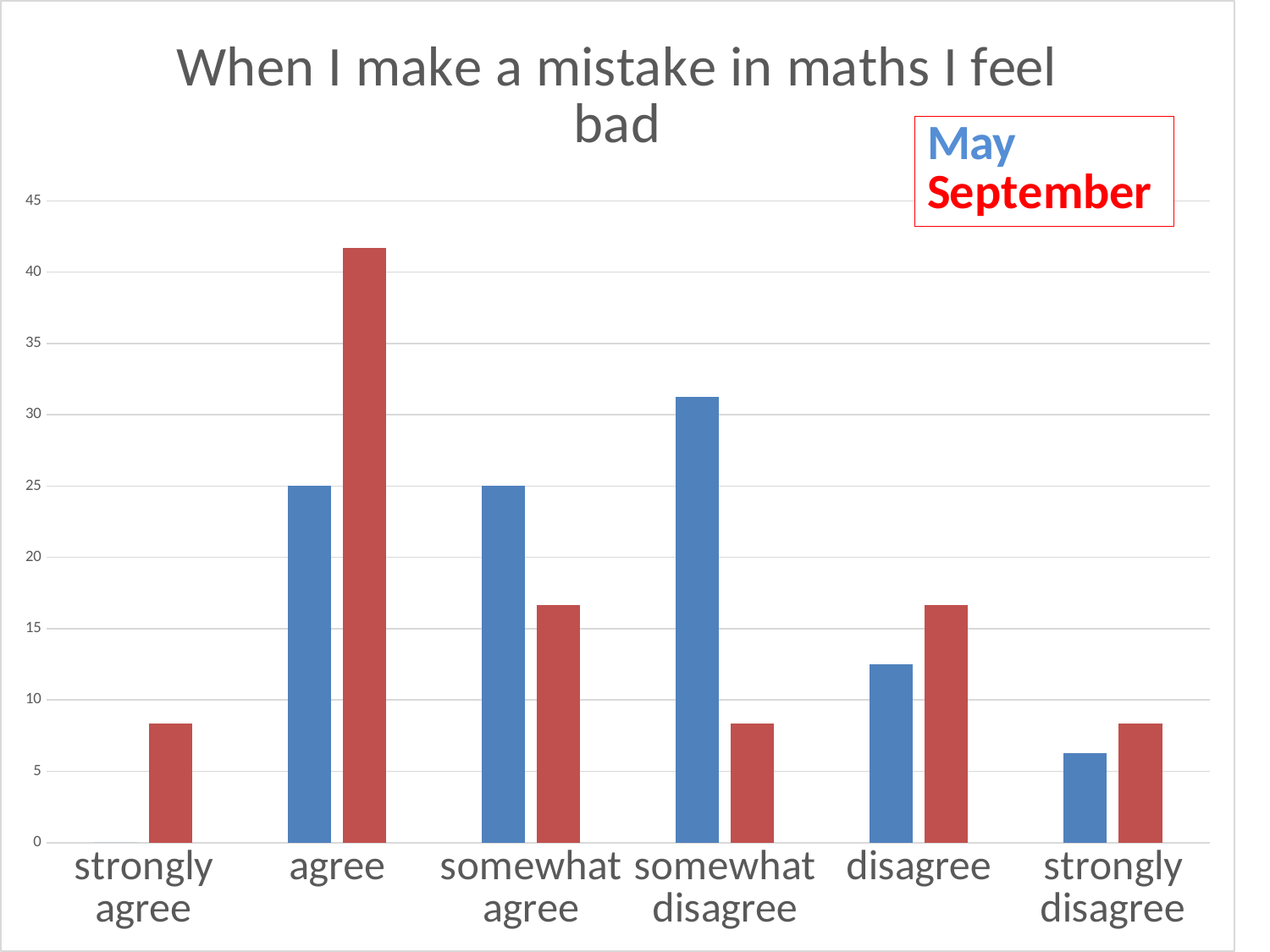
Which category has the highest May value? somewhat disagree Which category has the lowest May value? strongly agree Which category has the highest September value? agree Is the September value for strongly agree greater or less than 10? less Is the September value for agree greater or less than 40? greater How many series does the legend list? 2 What kind of chart is shown on the slide? bar chart What is the title of the chart? When I make a mistake in maths I feel bad Is the May value for somewhat disagree greater or less than 30? greater How many categories are shown on the x axis? 6 Which colour represents September in the chart? red For somewhat disagree, which is larger, the May value or the September value? May